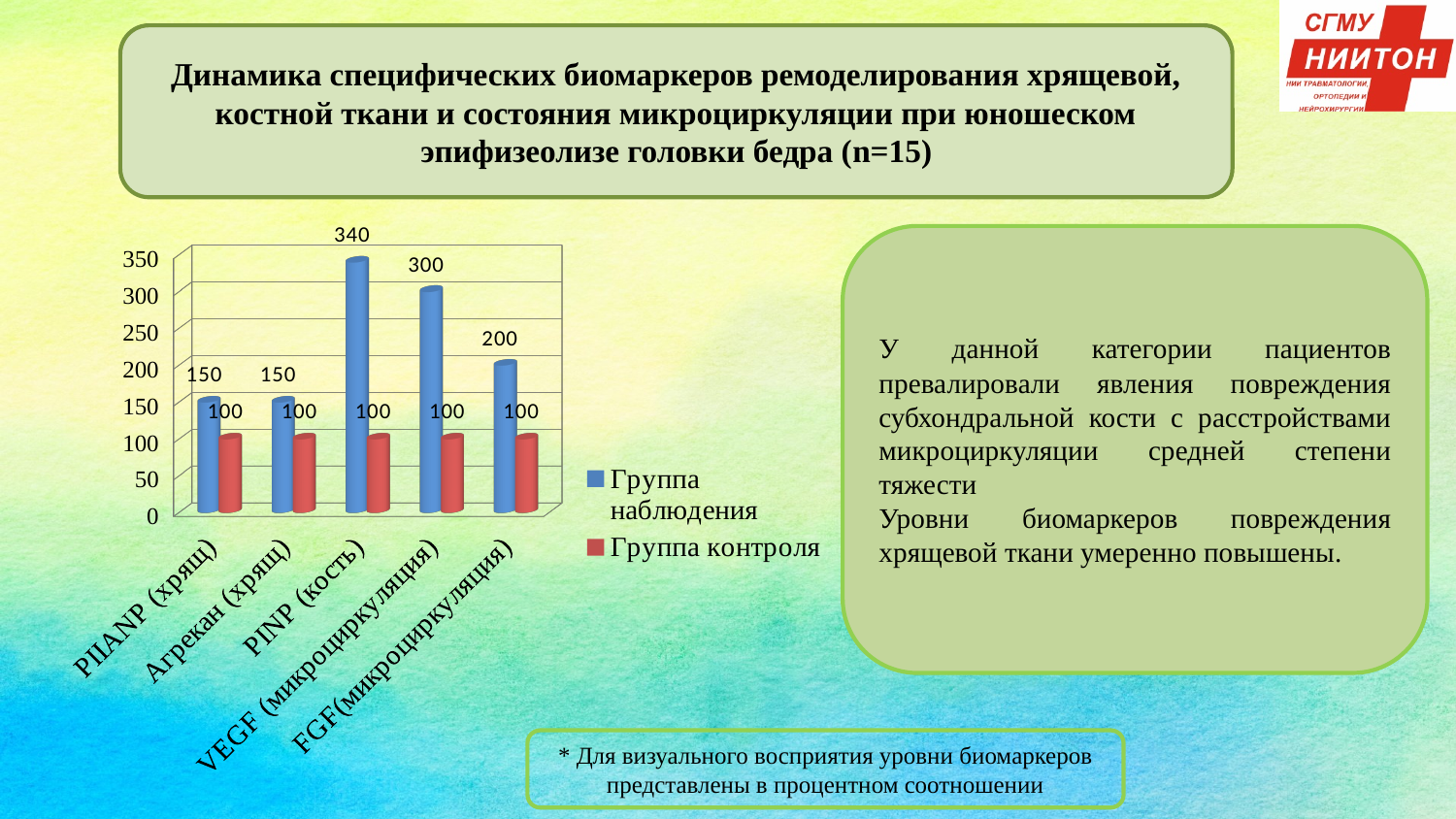
What is the value for Группа контроля for Агрекан (хрящ)? 100 What is the difference between the Группа наблюдения and Группа контроля values for PINP (кость)? 240 Which colour represents Группа контроля in the chart? Red What is the difference between the Группа наблюдения values for VEGF (микроциркуляция) and FGF(микроциркуляция)? 100 What is the value for Группа наблюдения for VEGF (микроциркуляция)? 300 Which is larger for Группа наблюдения: PIIANP (хрящ) or FGF(микроциркуляция)? FGF(микроциркуляция) How many series does the legend list? 2 What is the value for Группа наблюдения for PINP (кость)? 340 What is the value for Группа наблюдения for FGF(микроциркуляция)? 200 What kind of chart is shown on the slide? Bar chart How many categories are shown on the x axis? 5 Which category has the highest value for Группа наблюдения? PINP (кость)